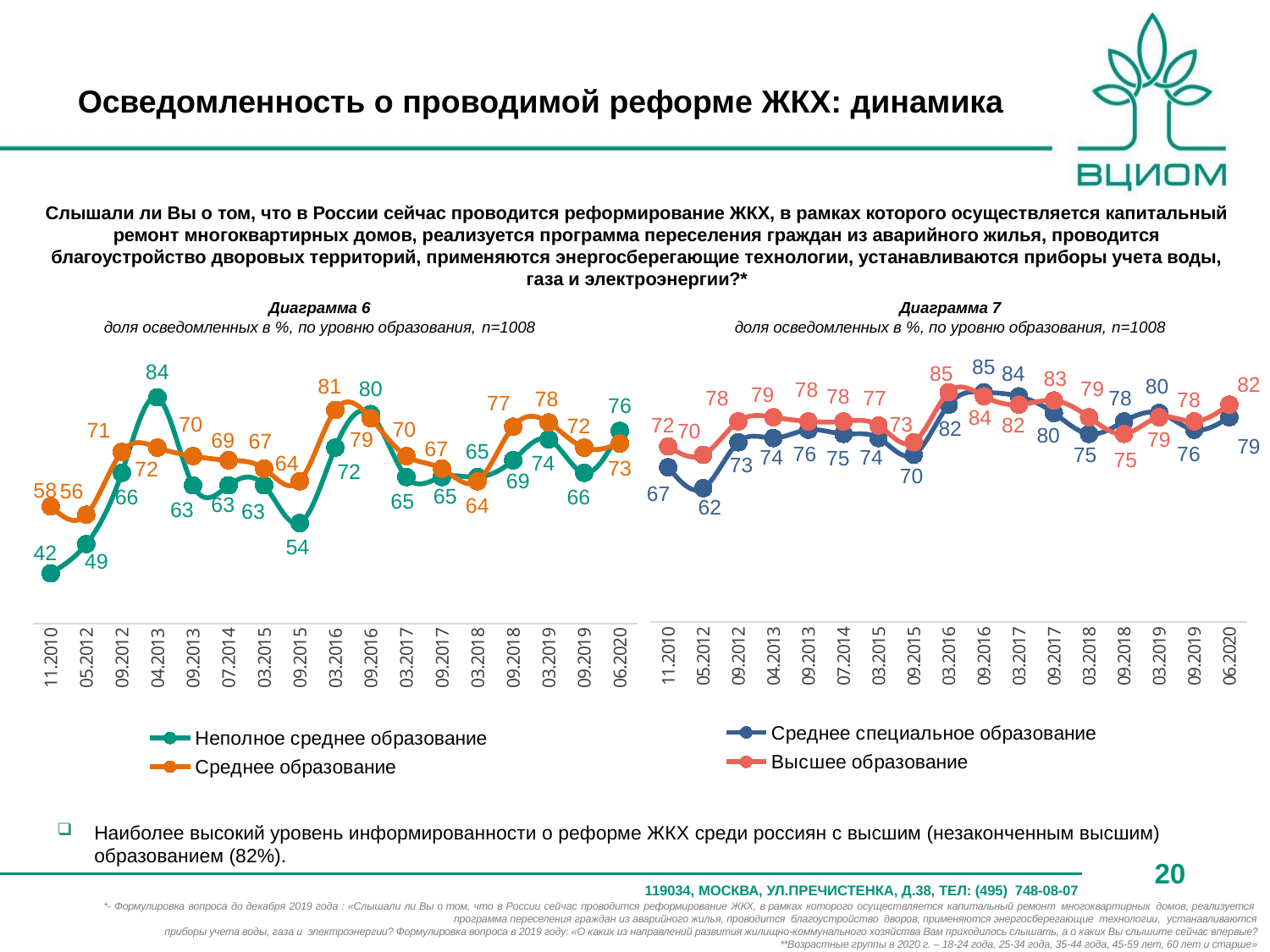
In Диаграмма 6, at which date is the value for Неполное среднее образование lowest? 11.2010 What type of chart is Диаграмма 7? Line chart In Диаграмма 7, what is the difference between Высшее образование and Среднее специальное образование at 09.2015? 3 In Диаграмма 7, what is the value for Высшее образование at 06.2020? 82 In Диаграмма 7, at which date is the value for Среднее специальное образование highest? 09.2016 In Диаграмма 6, what is the value for Среднее образование at 03.2016? 81 In Диаграмма 7, how many series does the legend list? 2 In Диаграмма 6, what is the difference between Среднее образование and Неполное среднее образование at 11.2010? 16 In Диаграмма 7, what is the value for Среднее специальное образование at 05.2012? 62 In Диаграмма 6, how many dates are plotted on the x axis? 17 In Диаграмма 6, which series has the higher value at 06.2020? Неполное среднее образование In Диаграмма 6, what is the value for Неполное среднее образование at 04.2013? 84